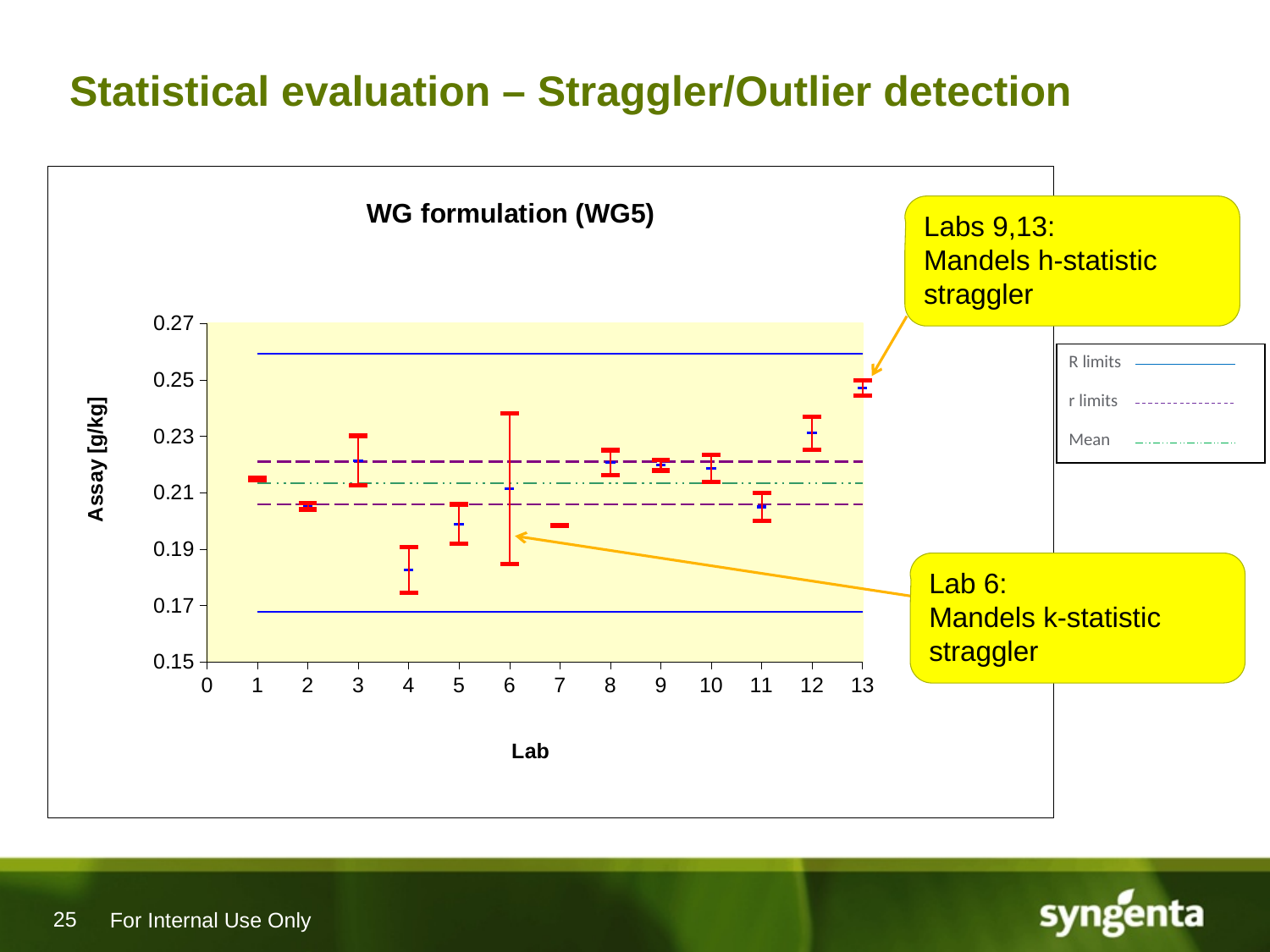
Is the assay value for Lab 4 greater or less than 0.21? less Is the assay value for Lab 7 greater or less than 0.21? less Which lab has the widest error bar on the chart? Lab 6 What kind of chart is shown on the slide? Scatter chart with error bars How many entries does the chart legend list? 3 Is the assay value for Lab 13 greater or less than 0.23? greater How many labs are plotted on the chart? 13 Which lab has the lowest assay value on the chart? Lab 4 Which lab has the highest assay value on the chart? Lab 13 What is the label of the y axis? Assay [g/kg] Which lab has the larger assay value, Lab 12 or Lab 7? Lab 12 What is the title of the chart? WG formulation (WG5)